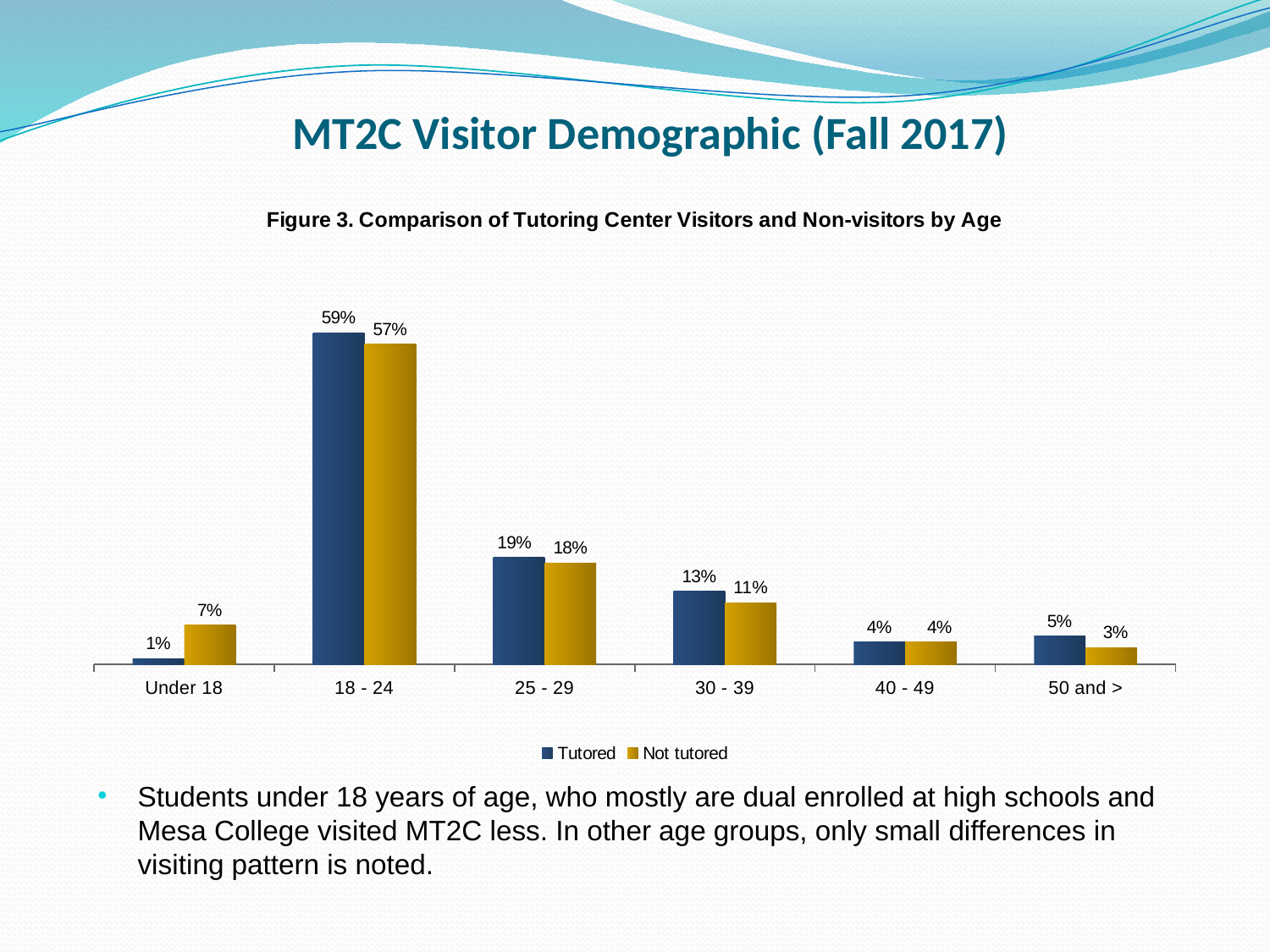
What is the Tutored value for the 18 - 24 age group? 59% How many age groups are shown on the x axis? 6 What is the title of the figure shown on the slide? Figure 3. Comparison of Tutoring Center Visitors and Non-visitors by Age What is the Not tutored value for the Under 18 age group? 7% Which age group has the lowest Tutored value? Under 18 What kind of chart is shown on the slide? Bar chart For the 50 and > age group, which is larger: the Tutored value or the Not tutored value? Tutored How many series does the legend list? 2 What is the difference between the Tutored and Not tutored values for the Under 18 age group? 6% What is the difference between the Tutored and Not tutored values for the 18 - 24 age group? 2% What is the Not tutored value for the 30 - 39 age group? 11% Which age group has the highest Tutored value? 18 - 24